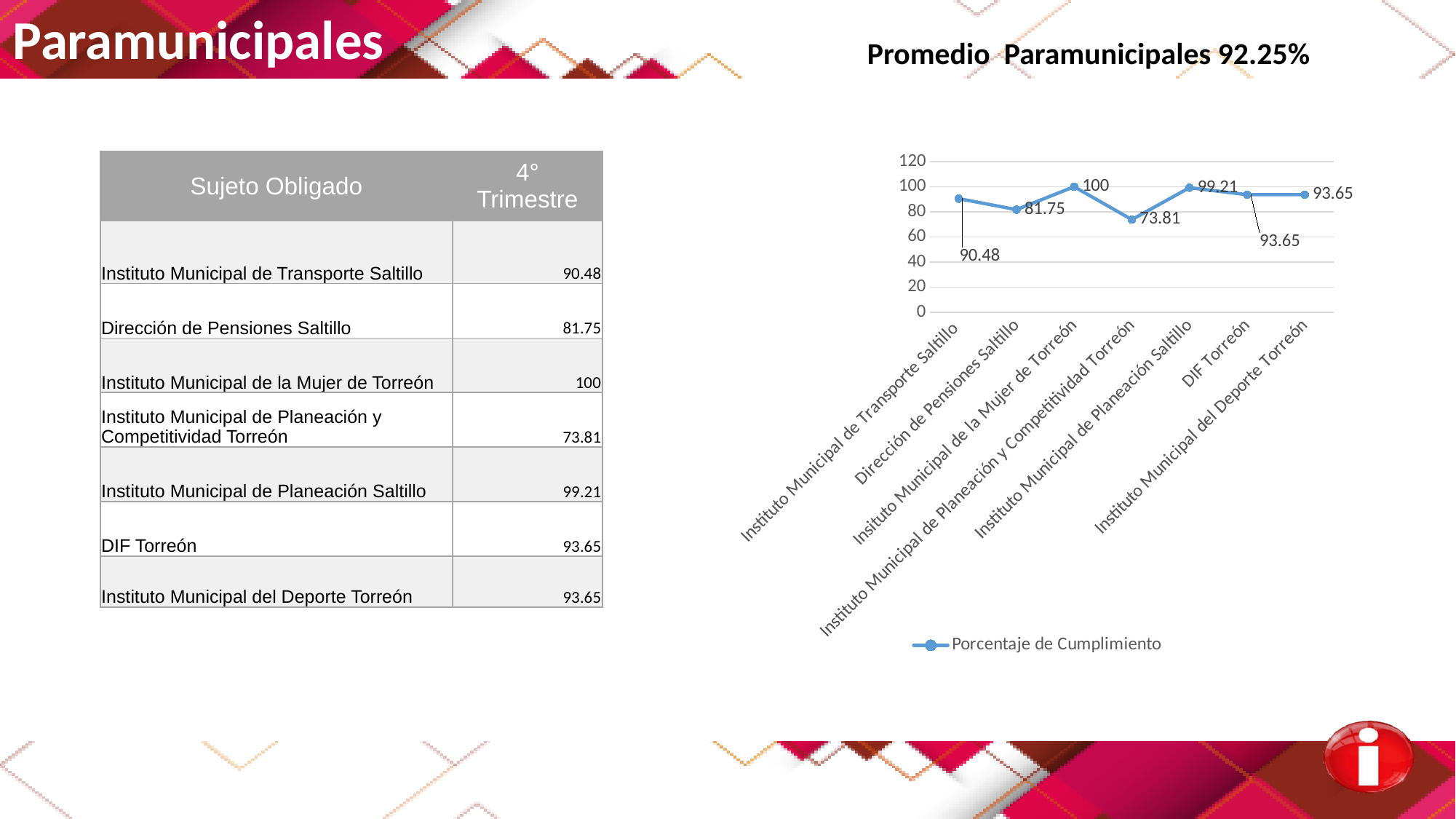
How many categories are plotted on the x axis of the chart? 7 What is the value for Dirección de Pensiones Saltillo in the chart? 81.75 What is the name of the series shown in the chart legend? Porcentaje de Cumplimiento What is the value for Instituto Municipal de Transporte Saltillo in the chart? 90.48 What type of chart is shown on the slide? line chart Which category has the highest value in the chart? Instituto Municipal de la Mujer de Torreón What is the value for Instituto Municipal de Planeación Saltillo in the chart? 99.21 Is the value for DIF Torreón greater or less than 80? greater Which is larger, the value for Instituto Municipal de Transporte Saltillo or the value for Dirección de Pensiones Saltillo? Instituto Municipal de Transporte Saltillo How many series does the chart legend list? 1 Which category has the lowest value in the chart? Instituto Municipal de Planeación y Competitividad Torreón What is the difference between the values for Instituto Municipal de la Mujer de Torreón and Instituto Municipal de Planeación y Competitividad Torreón? 26.19